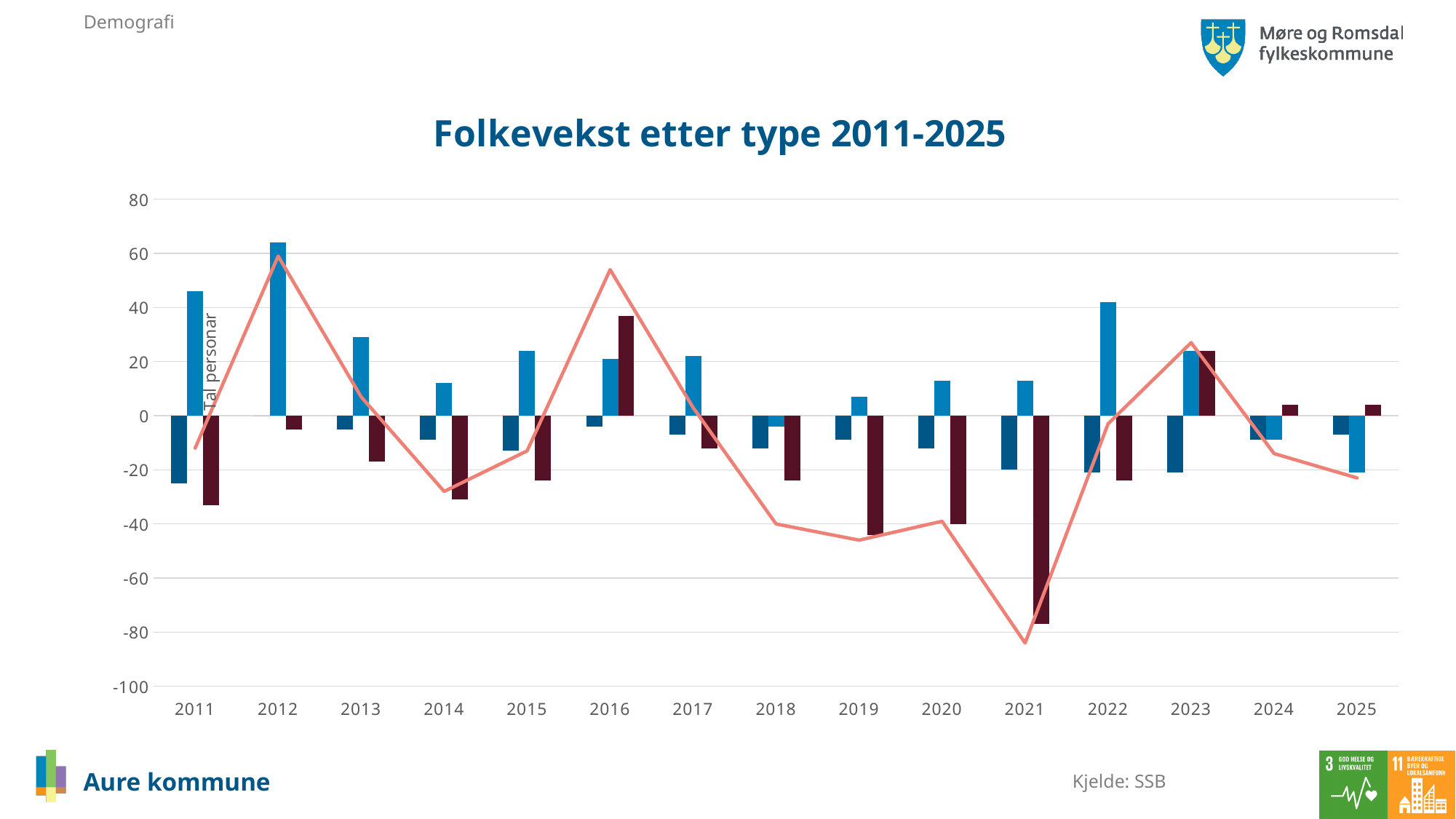
In which year is the dark red bar the lowest? 2021 In which year does the salmon line reach its lowest point? 2021 What kind of chart is shown on the slide? bar chart with a line Is the value of the dark red bar in 2021 greater or less than -60? less How many years are shown on the x axis of the chart? 15 What is the title of the chart? Folkevekst etter type 2011-2025 In which year is the light blue bar the highest? 2012 Is the value of the salmon line in 2021 greater or less than -80? less Which year has the larger light blue bar, 2011 or 2013? 2011 Is the value of the light blue bar in 2012 greater or less than 60? greater What is the label on the vertical axis of the chart? Tal personar